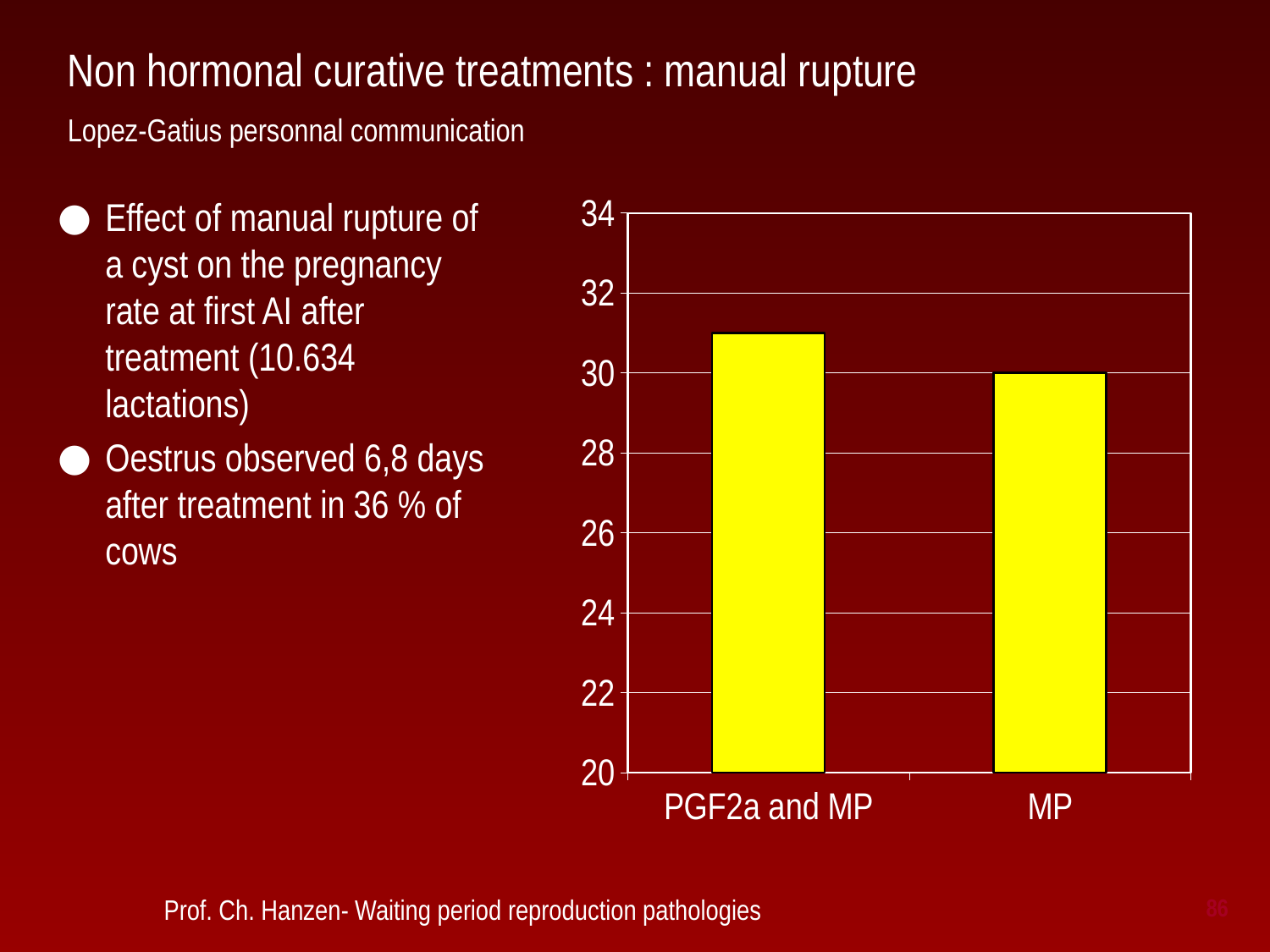
Is the value for PGF2a and MP greater or less than 30? greater What colour are the bars in the chart? yellow Which is larger, the value for PGF2a and MP or the value for MP? PGF2a and MP How many bars (categories) does the chart show? 2 What is the value for MP? 30 What kind of chart is shown on the slide? bar chart What is the lowest value shown on the vertical axis? 20 Is the value for MP greater or less than 28? greater Is the value for PGF2a and MP greater or less than 32? less Which category has the highest bar? PGF2a and MP Which category has the lowest bar? MP